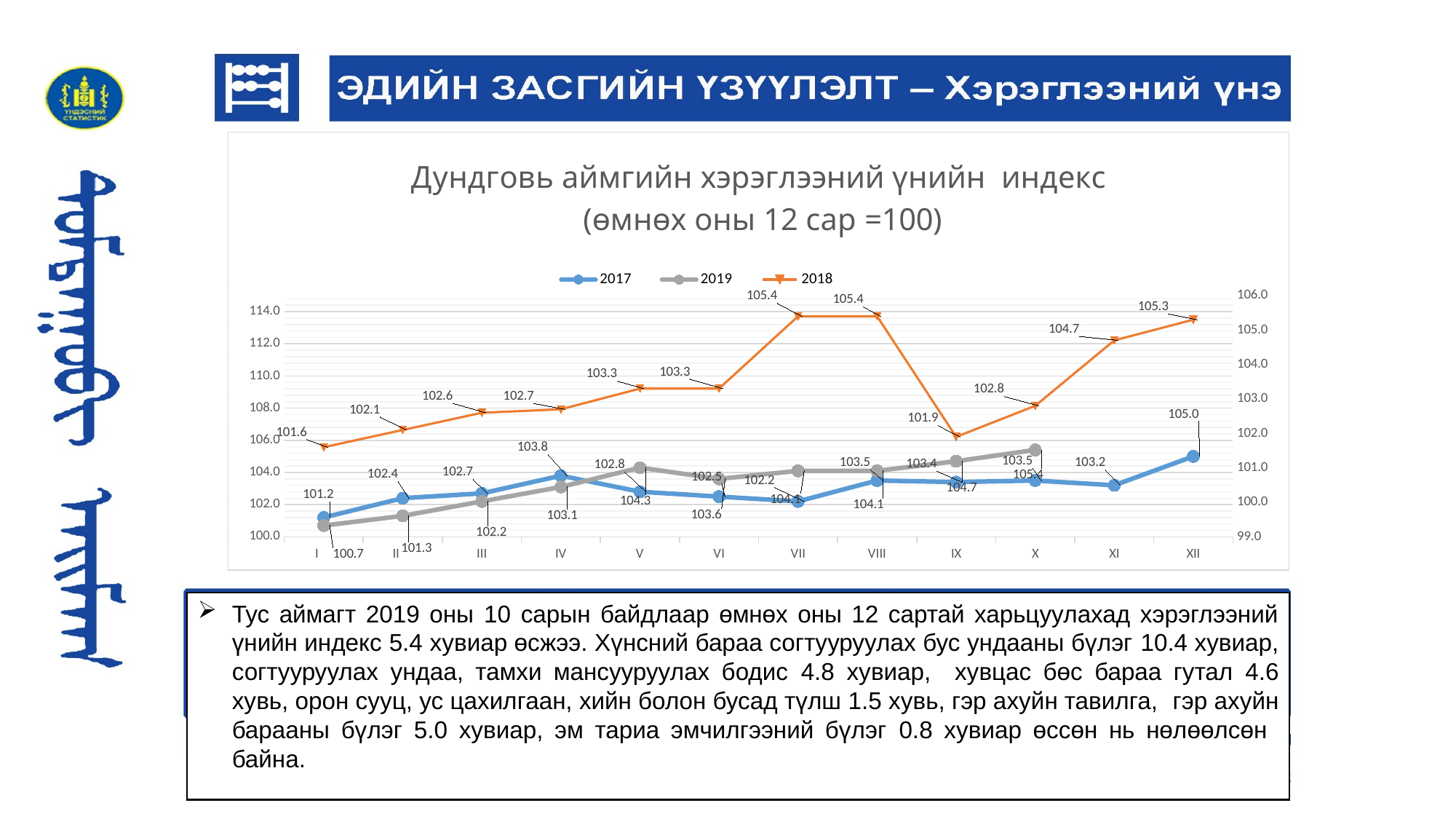
What is the difference between the 2018 values for month XII and month I? 3.7 How many series does the legend list? 3 What is the 2018 value for month IX? 101.9 What is the 2018 value for month I? 101.6 What is the 2017 value for month XII? 105.0 In which month is the 2018 series at its lowest? I How many months are shown along the x axis? 12 What is the title of the chart? Дундговь аймгийн хэрэглээний үнийн индекс (өмнөх оны 12 сар =100) What is the 2018 value for month XII? 105.3 What kind of chart is shown on the slide? line chart What is the 2019 value for month X? 105.4 Which is larger for the 2018 series: the value for month IX or the value for month X? month X